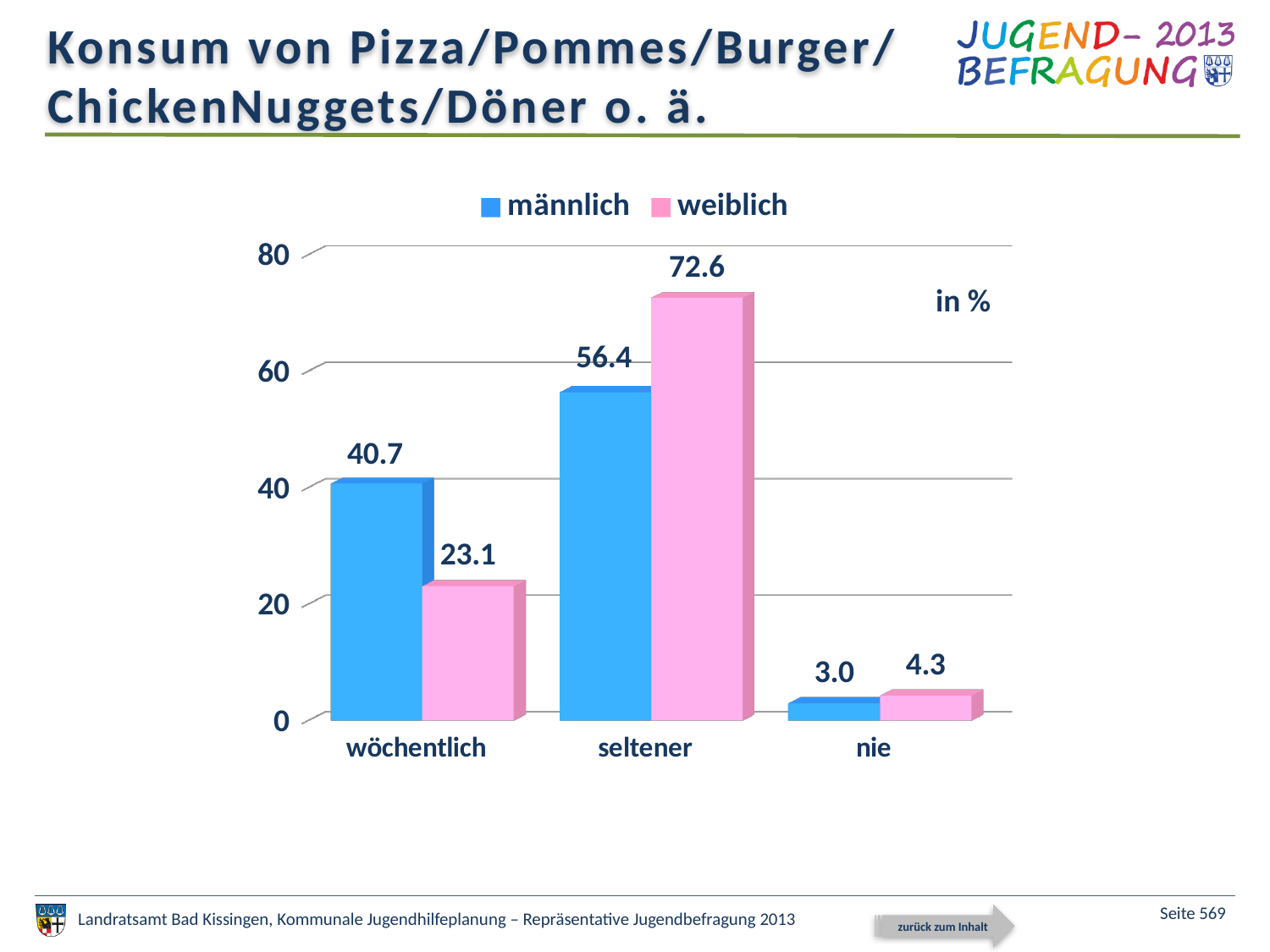
What is the value for weiblich in the seltener category? 72.6 Is the value for männlich in the seltener category greater or less than 60? less Which category has the lowest value for männlich? nie How many series does the legend list? 2 What is the difference between the weiblich and männlich values in the seltener category? 16.2 What is the value for weiblich in the nie category? 4.3 Which category has the highest value for weiblich? seltener In the wöchentlich category, which series has the larger value, männlich or weiblich? männlich What is the difference between the männlich and weiblich values in the wöchentlich category? 17.6 What kind of chart is shown on the slide? bar chart What is the value for männlich in the wöchentlich category? 40.7 How many categories are shown on the x axis? 3